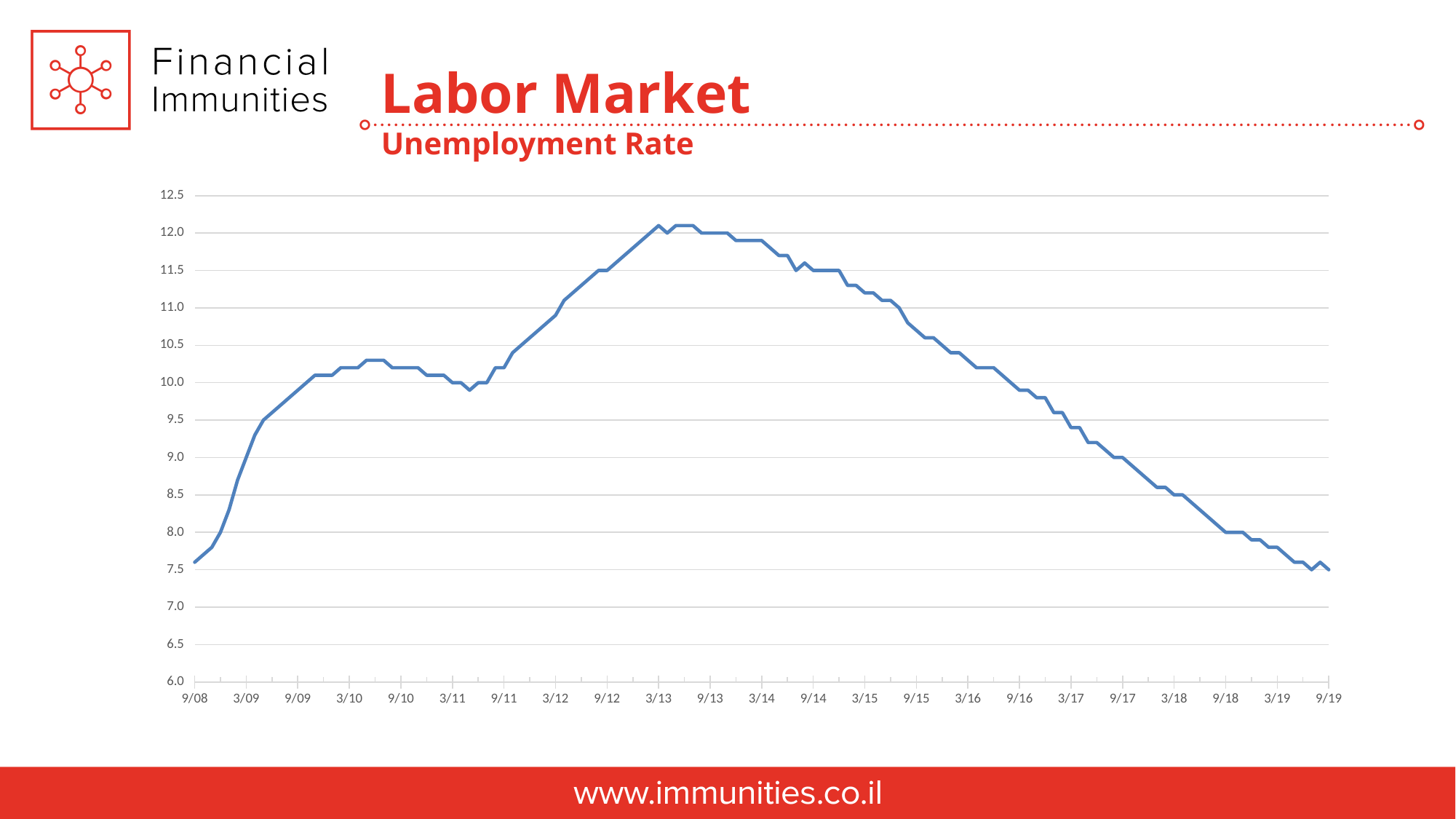
Is the unemployment rate at 9/16 greater or less than 10.5? less Is the unemployment rate at 3/15 greater or less than 11.0? greater What is the highest value shown on the y axis of the chart? 12.5 What is the title of the chart on the slide? Unemployment Rate Does the unemployment rate rise or fall between 9/08 and 3/13? rise Is the unemployment rate at 3/13 greater or less than 11.5? greater What kind of chart is shown on the slide? line chart Does the unemployment rate rise or fall between 9/13 and 9/19? fall Which is higher, the unemployment rate at 9/12 or at 9/16? 9/12 How many labels are shown on the x axis of the chart? 23